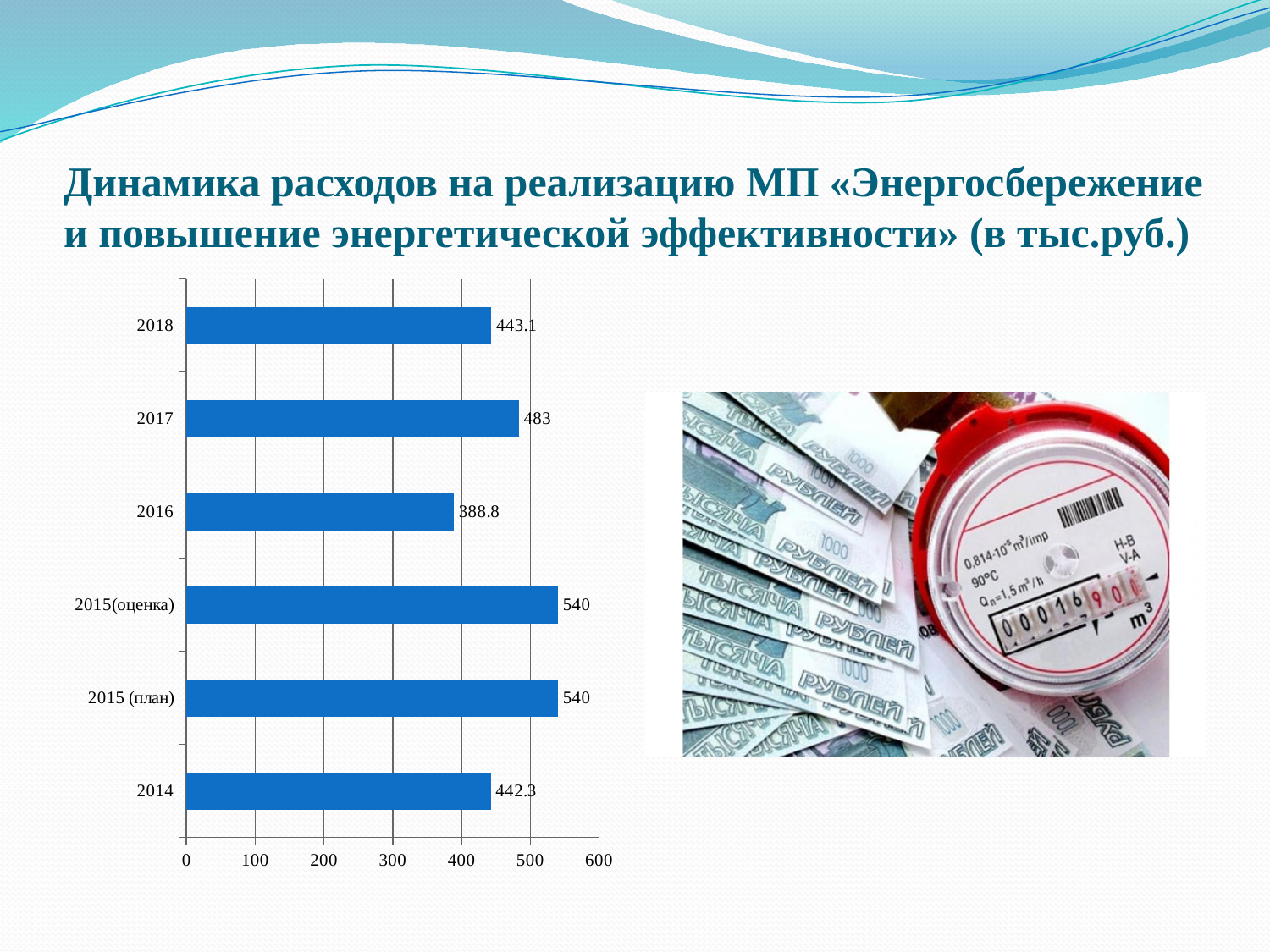
What is the value for 2016? 388.8 Is the value for 2016 greater or less than 400? less Which is larger, the value for 2017 or the value for 2016? 2017 What is the difference between the values for 2017 and 2016? 94.2 What is the difference between the values for 2015 (план) and 2014? 97.7 What is the maximum value shown on the horizontal axis? 600 What is the value for 2014? 442.3 How many categories are shown in the chart? 6 What is the value for 2018? 443.1 Which category has the lowest value? 2016 What is the value for 2015 (план)? 540 What kind of chart is shown on the slide? bar chart